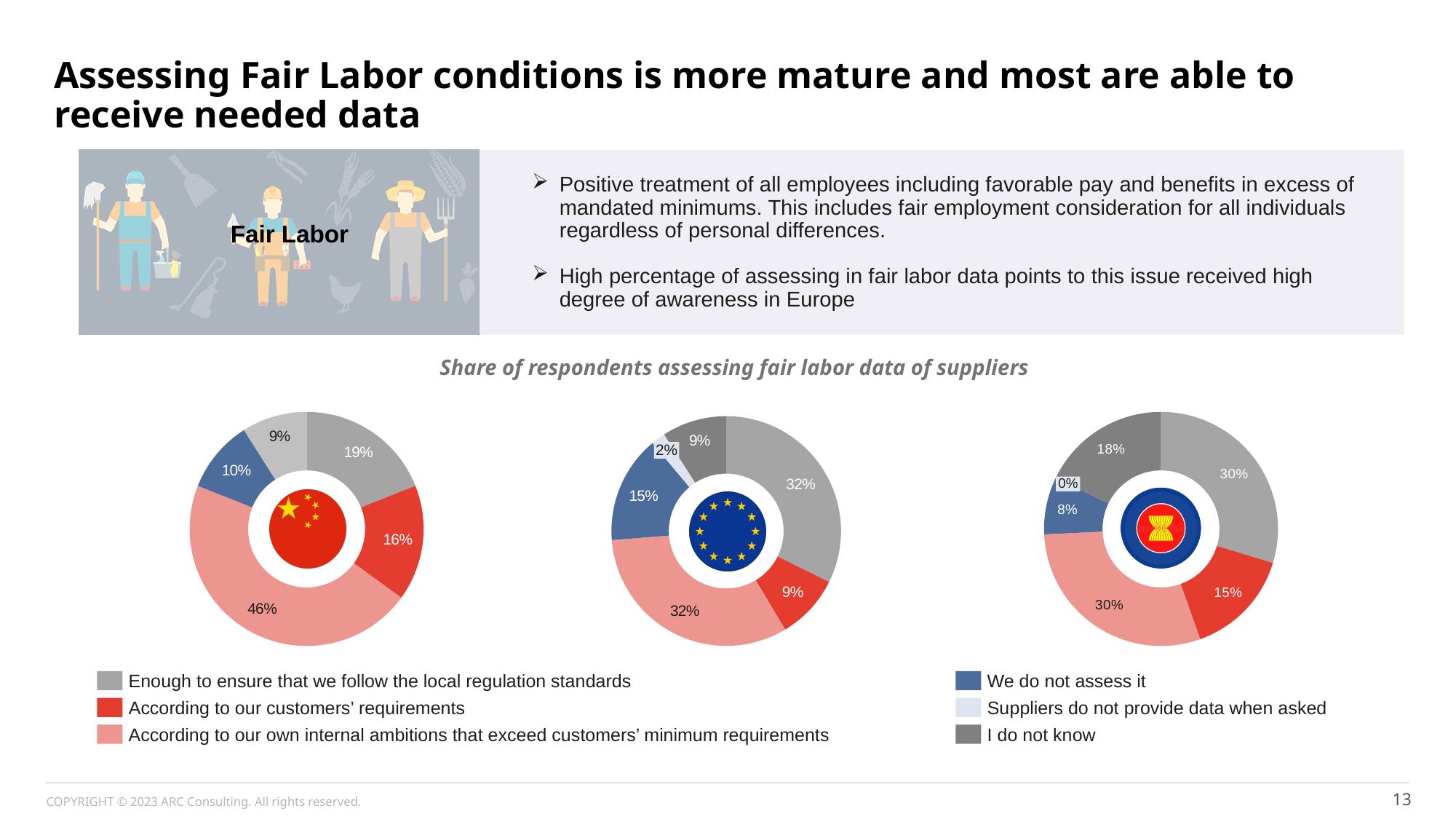
In the middle donut chart (EU flag), what share of respondents assess fair labor data according to their customers' requirements? 9% In the right donut chart (ASEAN flag), what share of respondents answered 'I do not know'? 18% In the right donut chart (ASEAN flag), which response category has the smallest share? Suppliers do not provide data when asked In the left donut chart (China flag), what share of respondents say they do not assess fair labor data? 10% What is the title shown above the three donut charts? Share of respondents assessing fair labor data of suppliers In the middle donut chart (EU flag), what is the difference between the share for 'We do not assess it' and the share for 'According to our customers' requirements'? 6% In the middle donut chart (EU flag), what share of respondents say suppliers do not provide data when asked? 2% Which chart shows a larger share for 'According to our customers' requirements': the left chart (China) or the right chart (ASEAN)? The left chart (China) In the left donut chart (China flag), what share of respondents assess fair labor data according to their own internal ambitions that exceed customers' minimum requirements? 46% In the right donut chart (ASEAN flag), what share of respondents say they do not assess fair labor data? 8% How many entries does the legend list for the donut charts? 6 In the left donut chart (China flag), which response category has the largest share? According to our own internal ambitions that exceed customers' minimum requirements